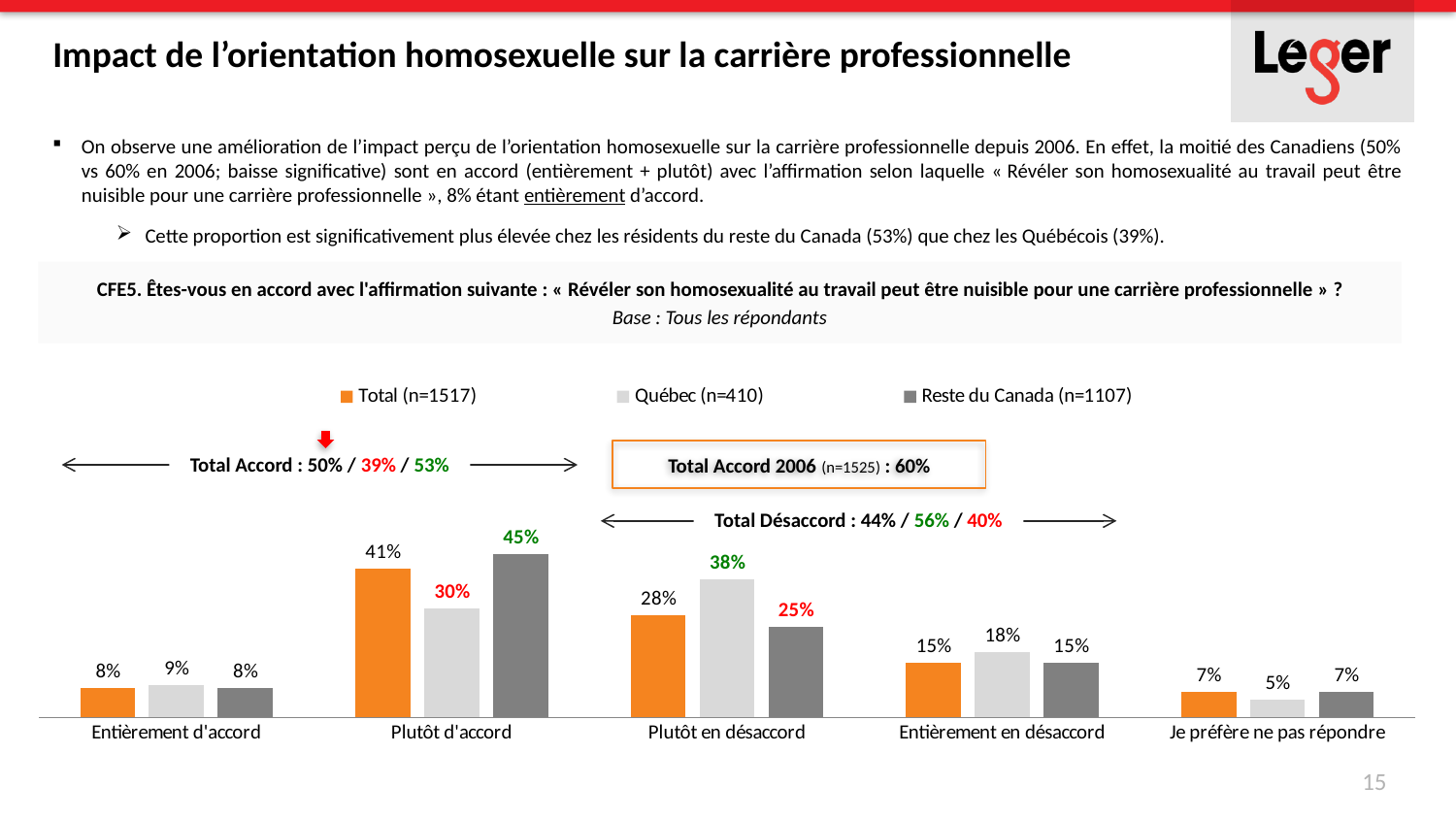
What is the difference between Reste du Canada (n=1107) and Québec (n=410) in the 'Plutôt d'accord' category? 15% What kind of chart is shown on the slide? Bar chart What is the value for Reste du Canada (n=1107) in the 'Entièrement en désaccord' category? 15% What is the Total Accord value for 2006 shown on the chart? 60% What is the value for Québec (n=410) in the 'Je préfère ne pas répondre' category? 5% In the 'Plutôt en désaccord' category, which series has the larger value: Québec (n=410) or Reste du Canada (n=1107)? Québec (n=410) Which category has the lowest value for the Québec (n=410) series? Je préfère ne pas répondre What is the value for Québec (n=410) in the 'Plutôt en désaccord' category? 38% What is the value for Total (n=1517) in the 'Plutôt d'accord' category? 41% How many categories are shown on the x axis of the chart? 5 Which category has the highest value for the Total (n=1517) series? Plutôt d'accord How many series does the legend list? 3